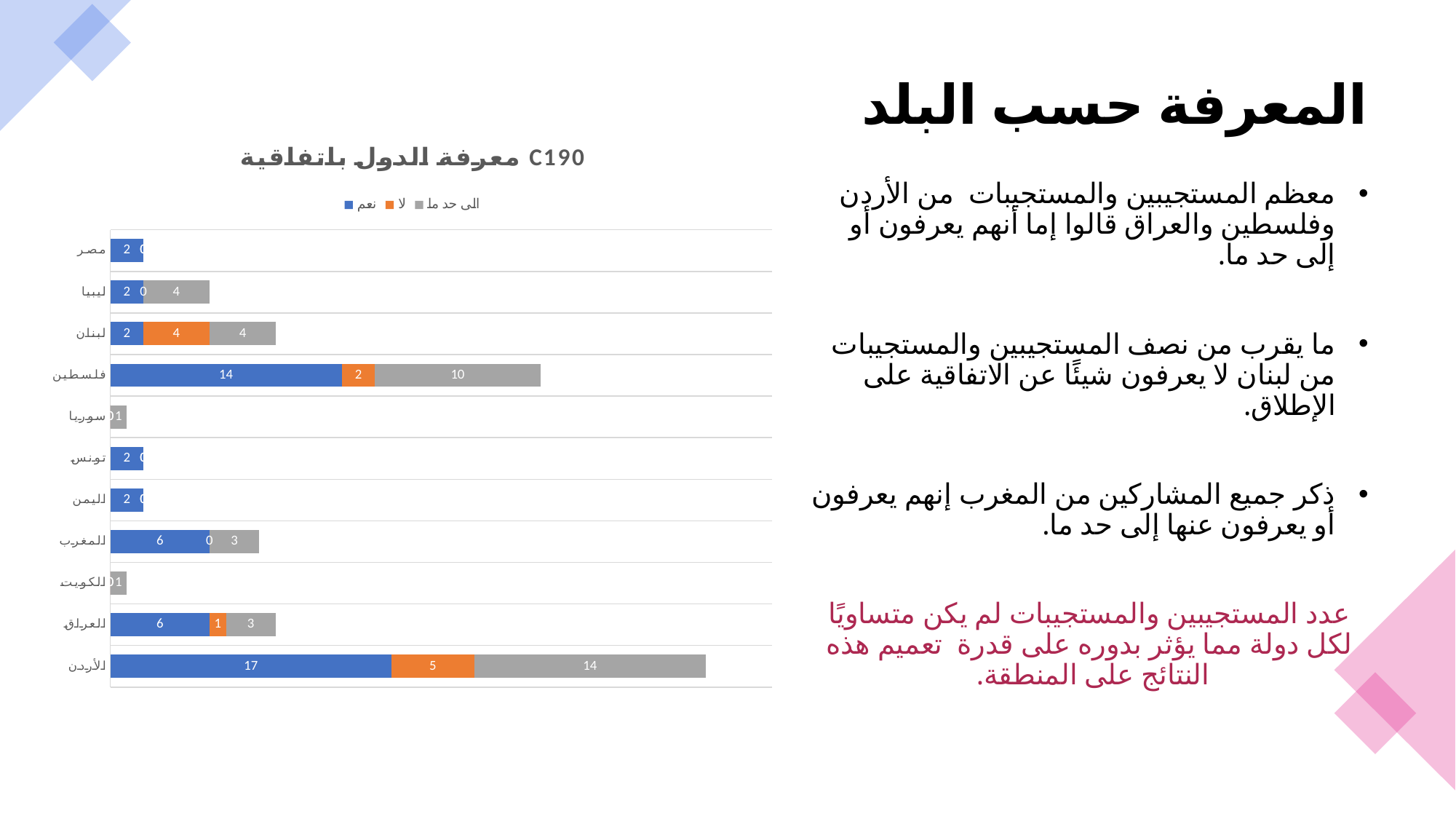
What is the total of the stacked bar for فلسطين? 26 What is the total of the stacked bar for الأردن? 36 How many series does the chart legend list? 3 What is the difference between the نعم values for الأردن and فلسطين? 3 How many countries are shown on the chart? 11 What is the value of نعم for الأردن? 17 What is the value of إلى حد ما for فلسطين? 10 What is the value of لا for لبنان? 4 Which country has the highest value for نعم? الأردن Which is larger, the لا value for الأردن or the لا value for العراق? الأردن What is the title of the chart? معرفة الدول باتفاقية C190 What kind of chart is shown on the slide? Bar chart